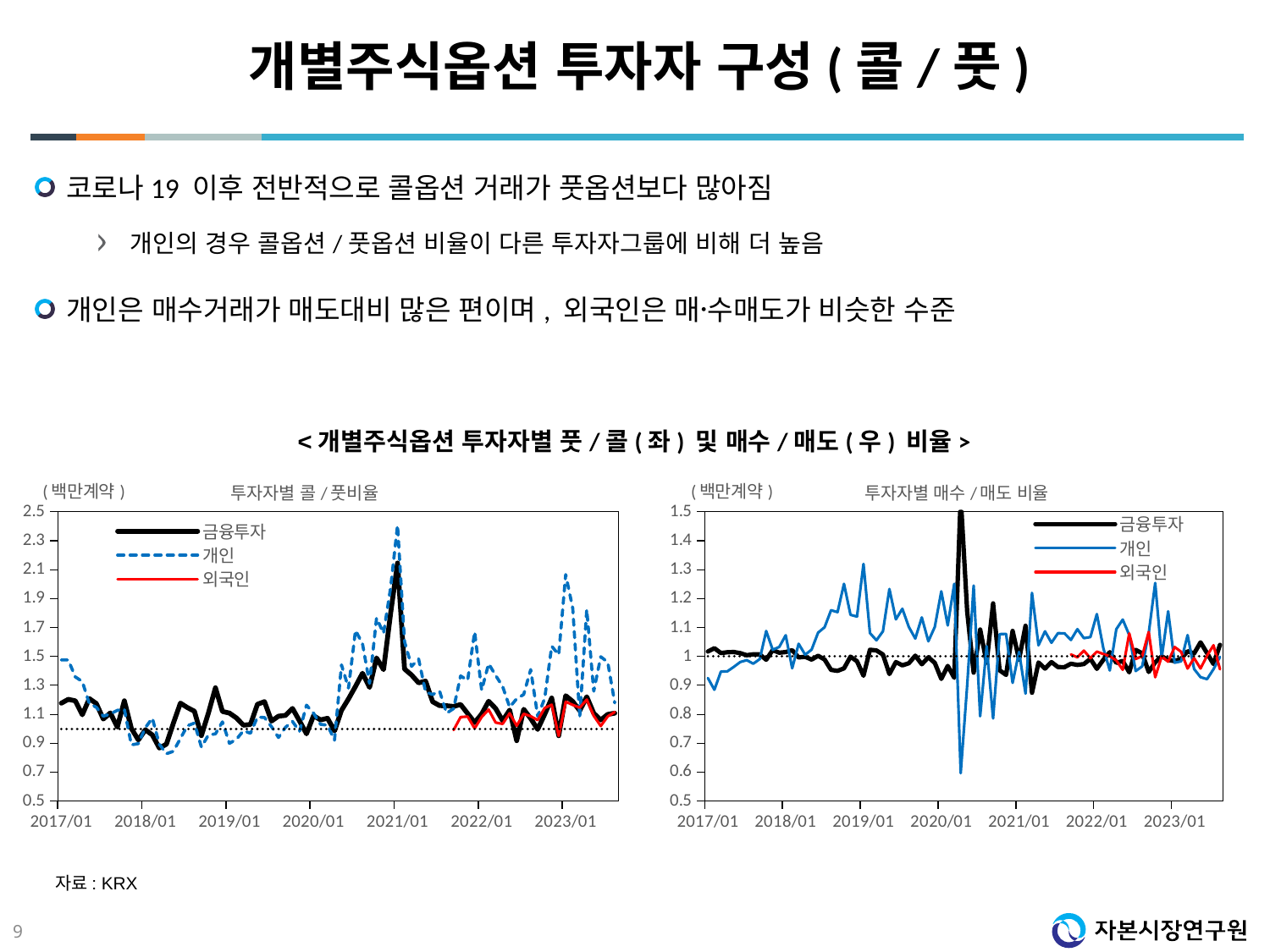
In the left chart (투자자별 콜/풋비율), which series reaches the highest value around 2021/01? 개인 What kind of chart is the left chart titled 투자자별 콜/풋비율? line chart How many year labels are shown on the x axis of the left chart (투자자별 콜/풋비율)? 7 What is the title of the left chart? 투자자별 콜/풋비율 In the left chart (투자자별 콜/풋비율), how many series does the legend list? 3 In the right chart (투자자별 매수/매도 비율), how many series does the legend list? 3 In the right chart (투자자별 매수/매도 비율), is the lowest value of 개인 around 2020 greater or less than 0.7? less In the left chart (투자자별 콜/풋비율), is the peak value of 개인 around 2021/01 greater or less than 2.1? greater In the right chart (투자자별 매수/매도 비율), is the peak value of 금융투자 around 2020 greater or less than 1.4? greater What is the title of the right chart? 투자자별 매수/매도 비율